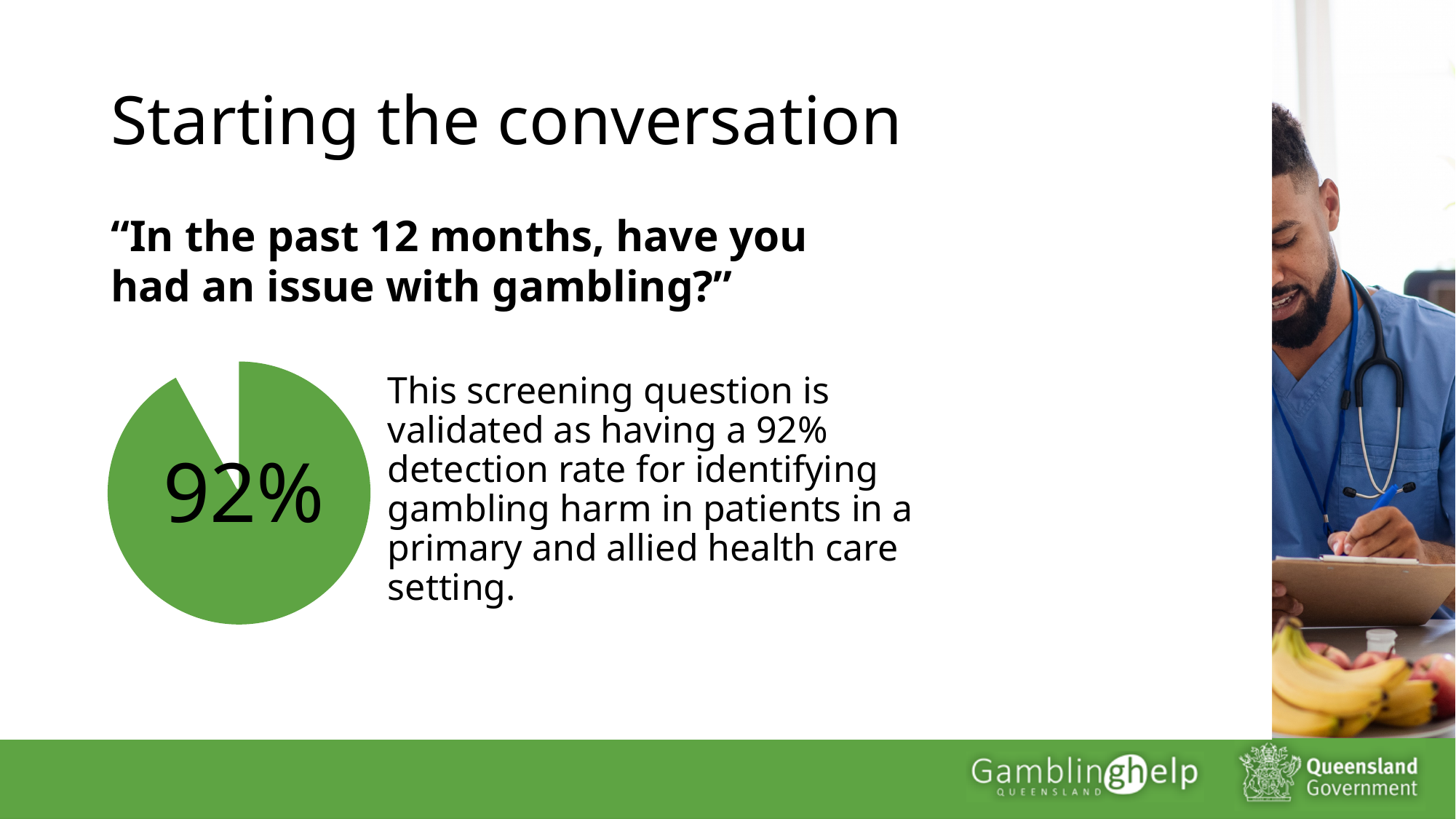
What does the 92% on the pie chart represent, according to the text beside it? the detection rate of the screening question How many slices does the pie chart have? 2 Is the green slice of the pie chart larger or smaller than the remaining slice? larger What kind of chart is shown on the slide? pie chart What share of the pie does the green slice represent? 92% What percentage is printed on the pie chart? 92% What colour is the large slice of the pie chart? green